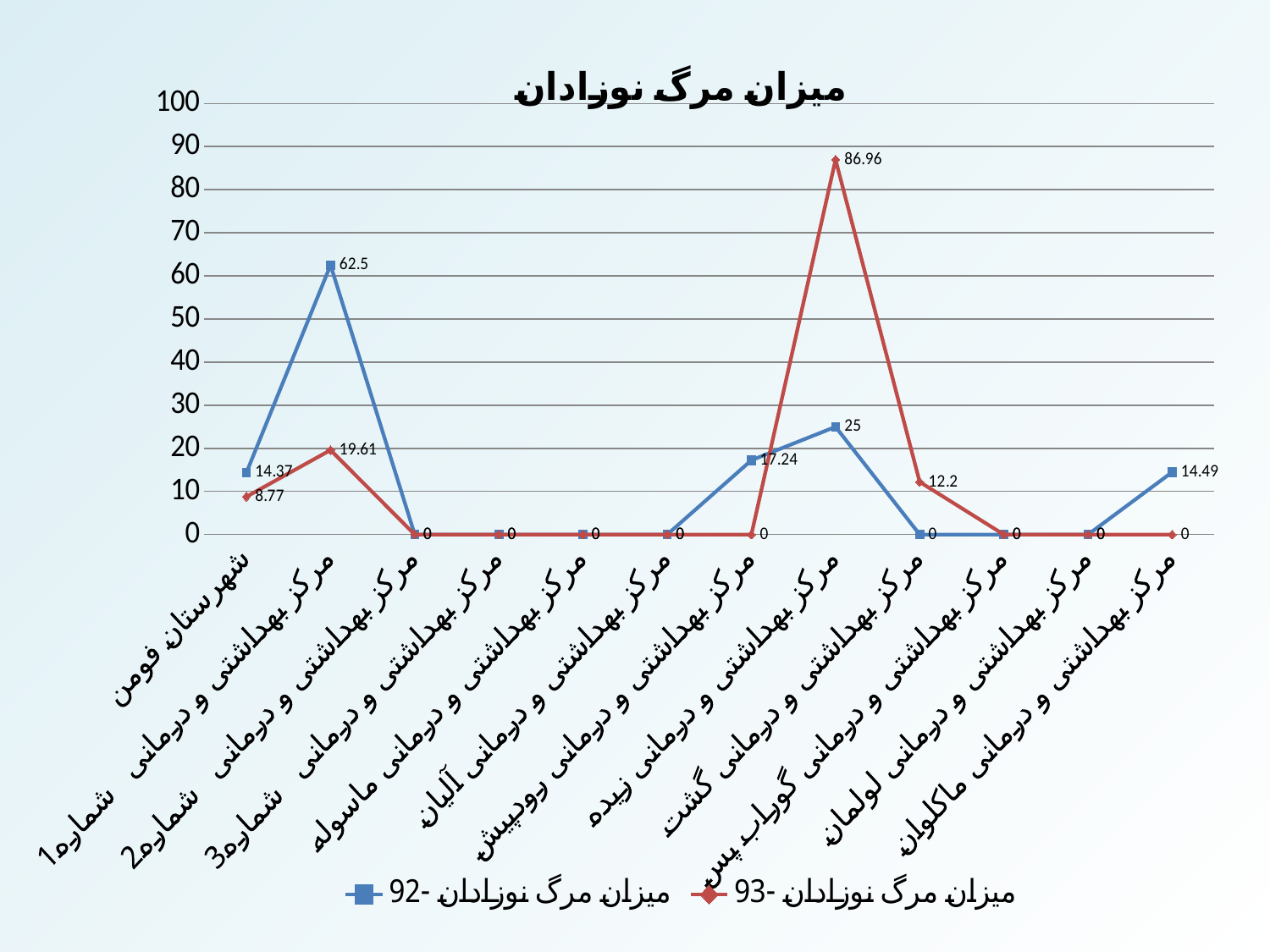
For 'مرکز بهداشتی و درمانی شماره1', which series has the larger value, 'میزان مرگ نوزادان -92' or 'میزان مرگ نوزادان -93'? میزان مرگ نوزادان -92 What type of chart is shown on the slide? line chart What is the value of the series 'میزان مرگ نوزادان -93' for 'شهرستان فومن'? 8.77 What is the difference between the 'میزان مرگ نوزادان -93' and 'میزان مرگ نوزادان -92' values for 'مرکز بهداشتی و درمانی زیده'? 61.96 What is the value of the series 'میزان مرگ نوزادان -92' for 'مرکز بهداشتی و درمانی ماکلوان'? 14.49 Which category has the highest value in the series 'میزان مرگ نوزادان -92'? مرکز بهداشتی و درمانی شماره1 Which category has the highest value in the series 'میزان مرگ نوزادان -93'? مرکز بهداشتی و درمانی زیده How many series does the legend list? 2 What is the value of the series 'میزان مرگ نوزادان -92' for 'مرکز بهداشتی و درمانی شماره1'? 62.5 What is the value of the series 'میزان مرگ نوزادان -93' for 'مرکز بهداشتی و درمانی زیده'? 86.96 What is the title of the chart? میزان مرگ نوزادان How many categories are shown on the x axis? 12